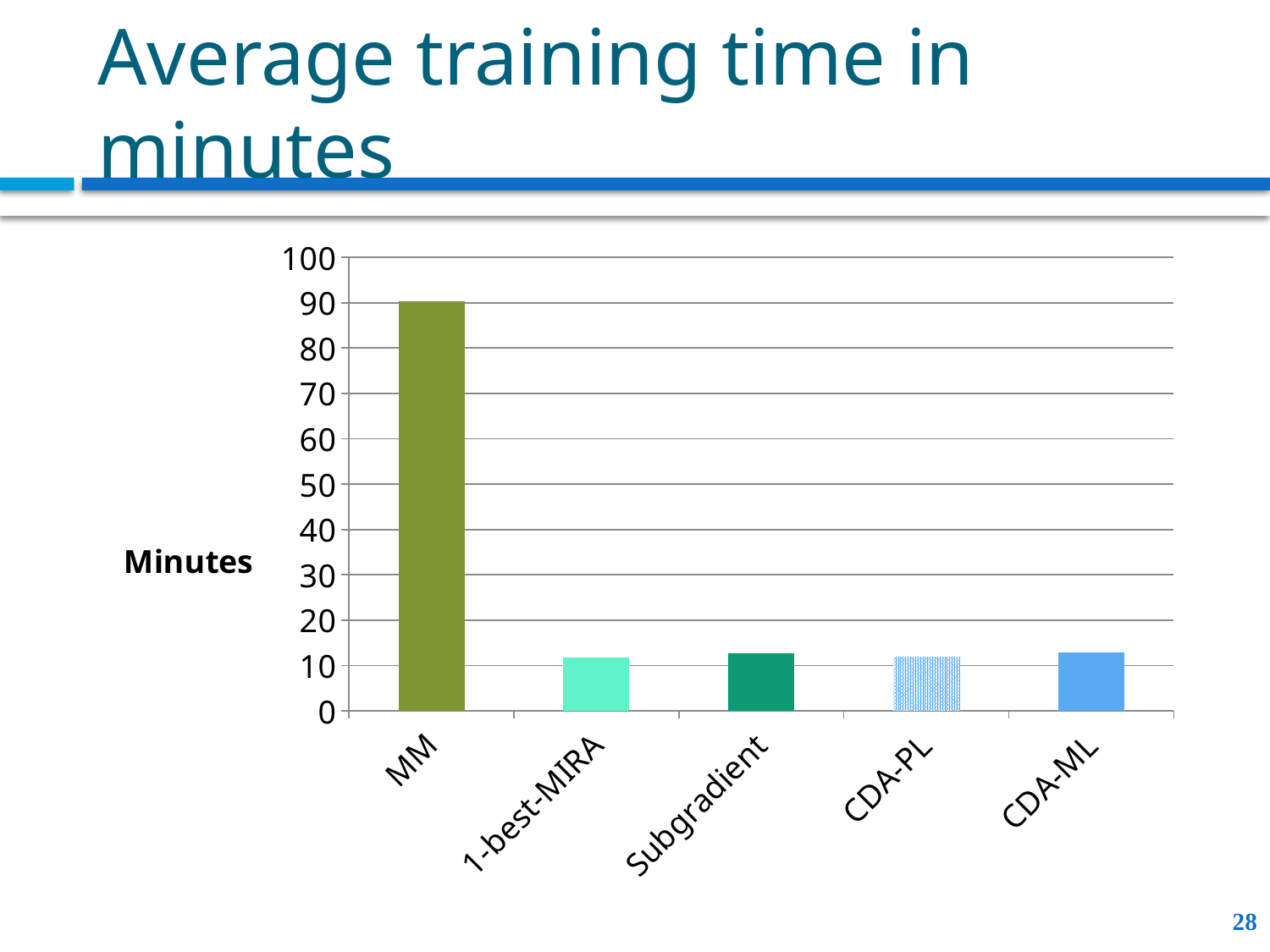
How many categories are plotted on the x axis? 5 Is the value for 1-best-MIRA greater or less than 20? less What kind of chart is shown on the slide? bar chart Is the value for CDA-ML greater or less than 10? greater What is the label on the vertical axis of the chart? Minutes What is the title of the slide? Average training time in minutes Is the value for CDA-PL greater or less than 20? less Which is larger, the value for MM or the value for Subgradient? MM Which category has the highest average training time? MM